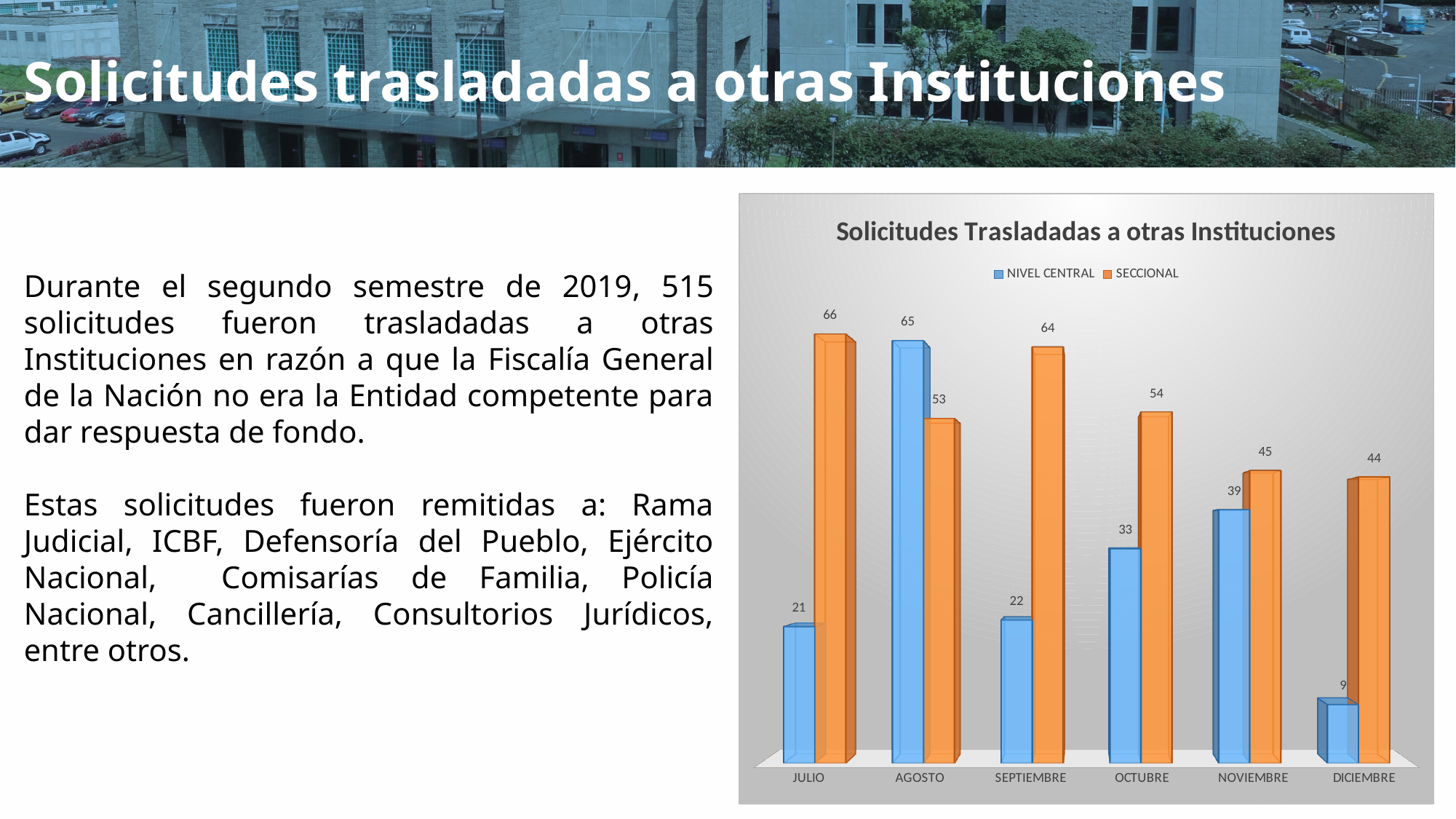
What is the difference between the SECCIONAL and NIVEL CENTRAL values for SEPTIEMBRE? 42 What is the NIVEL CENTRAL value for DICIEMBRE? 9 Which month has the highest NIVEL CENTRAL value? AGOSTO What is the SECCIONAL value for OCTUBRE? 54 How many months are shown on the x axis? 6 Which is larger for AGOSTO, NIVEL CENTRAL or SECCIONAL? NIVEL CENTRAL Which month has the lowest SECCIONAL value? DICIEMBRE What kind of chart is shown? Bar chart What is the NIVEL CENTRAL value for AGOSTO? 65 How many series does the legend list? 2 What is the SECCIONAL value for JULIO? 66 What is the title of the chart? Solicitudes Trasladadas a otras Instituciones